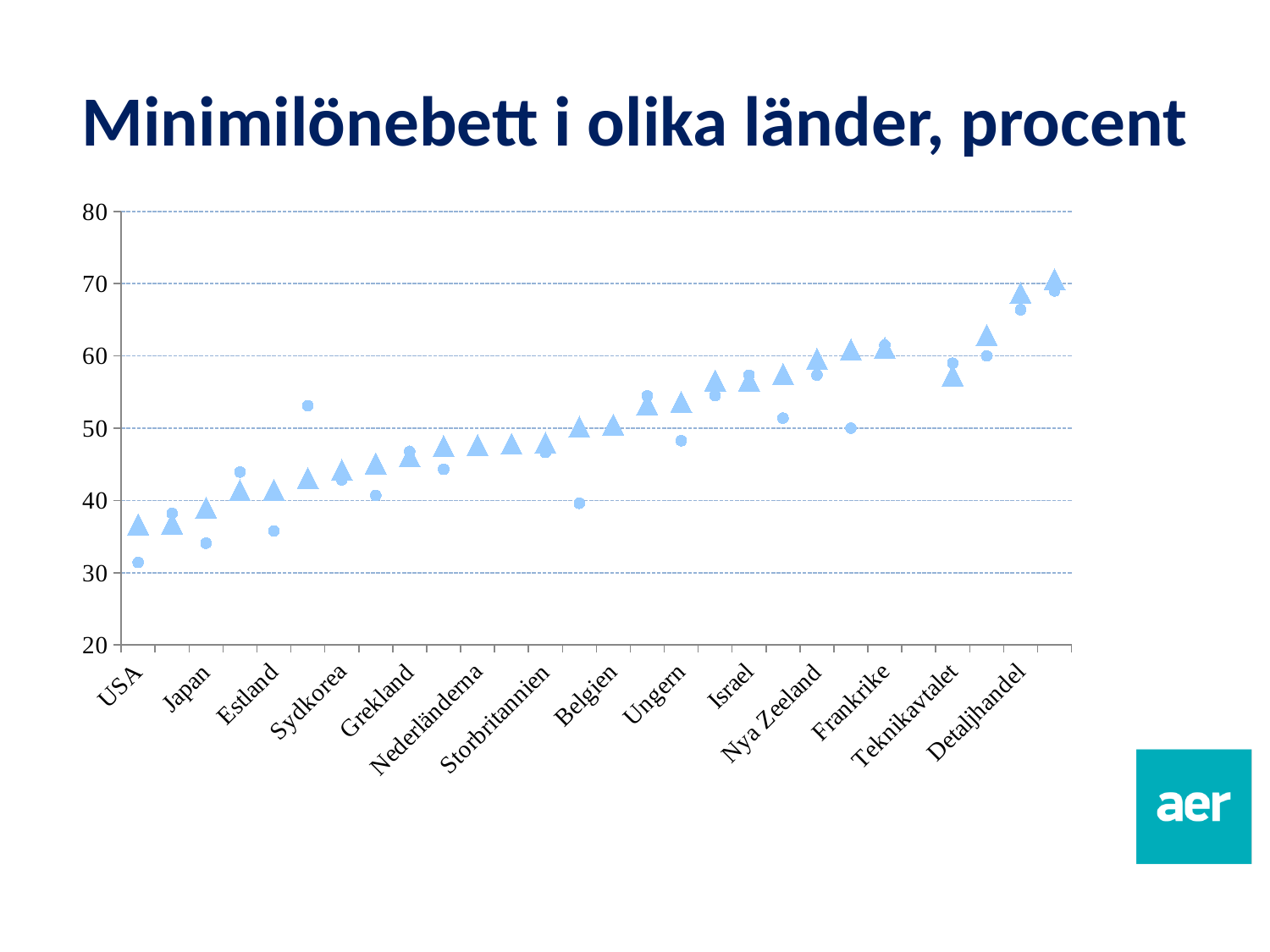
Do the plotted values generally rise or fall from left to right along the x axis? rise Which labelled category has the highest plotted values? Detaljhandel Is the circle-marker value for Israel greater or less than 50? greater What is the title of the chart? Minimilönebett i olika länder, procent Is the triangle-marker value for Teknikavtalet greater or less than 60? less Is the circle-marker value for Ungern greater or less than 50? less How many category labels are shown on the x axis? 14 Which labelled category has the lowest plotted values? USA What kind of chart is shown on the slide? scatter chart